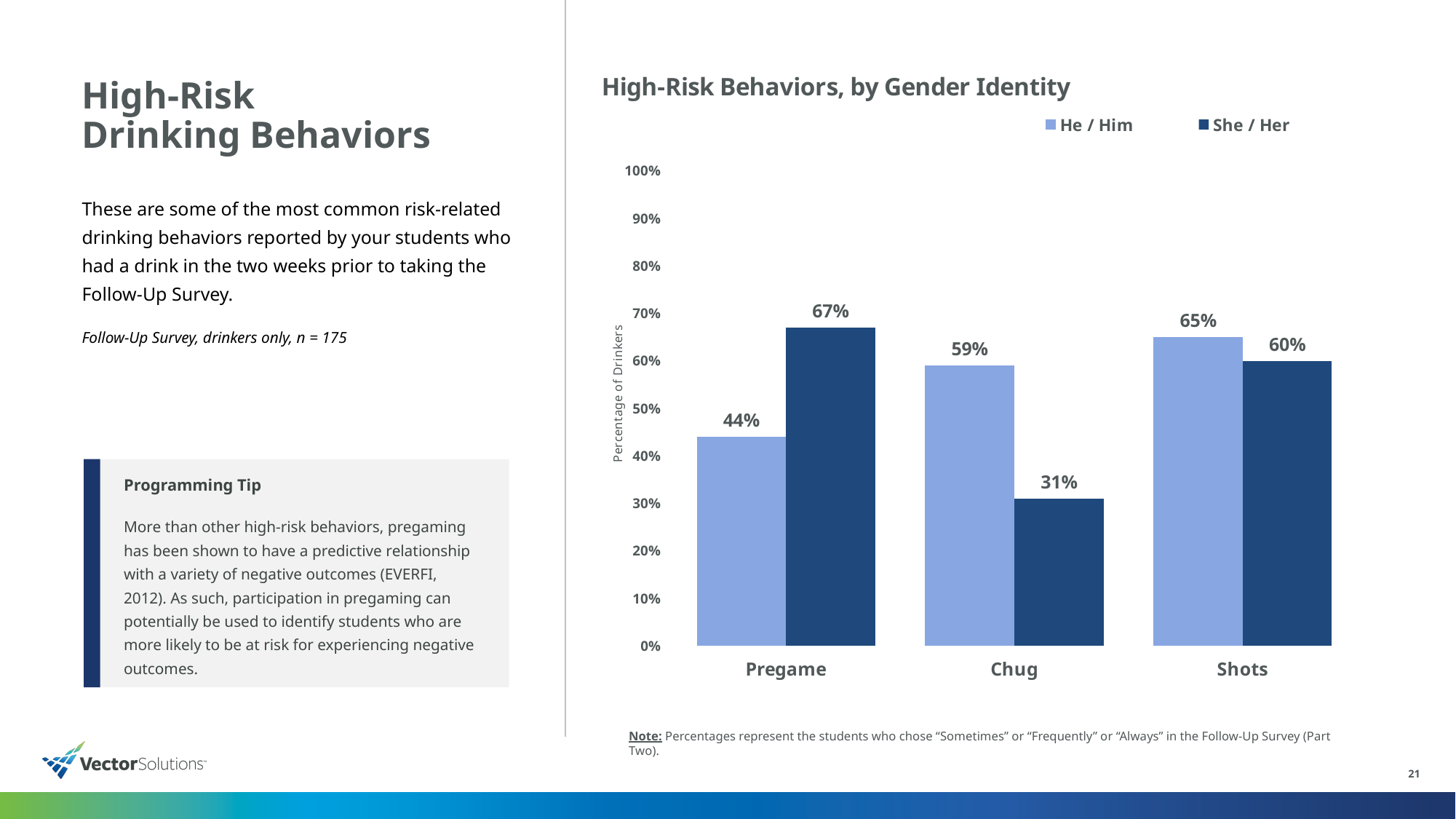
What is the difference between the He / Him and She / Her values for Chug? 28% Which behavior has the lowest He / Him percentage? Pregame What is the difference between the She / Her and He / Him values for Pregame? 23% What is the title of the chart? High-Risk Behaviors, by Gender Identity What percentage of She / Her drinkers reported chugging? 31% Which behavior has the highest She / Her percentage? Pregame What is the She / Her value for Shots? 60% How many series does the legend list? 2 How many behavior categories are shown on the x axis? 3 For Shots, which group has the higher percentage, He / Him or She / Her? He / Him What type of chart is shown? Bar chart What percentage of He / Him drinkers reported pregaming? 44%